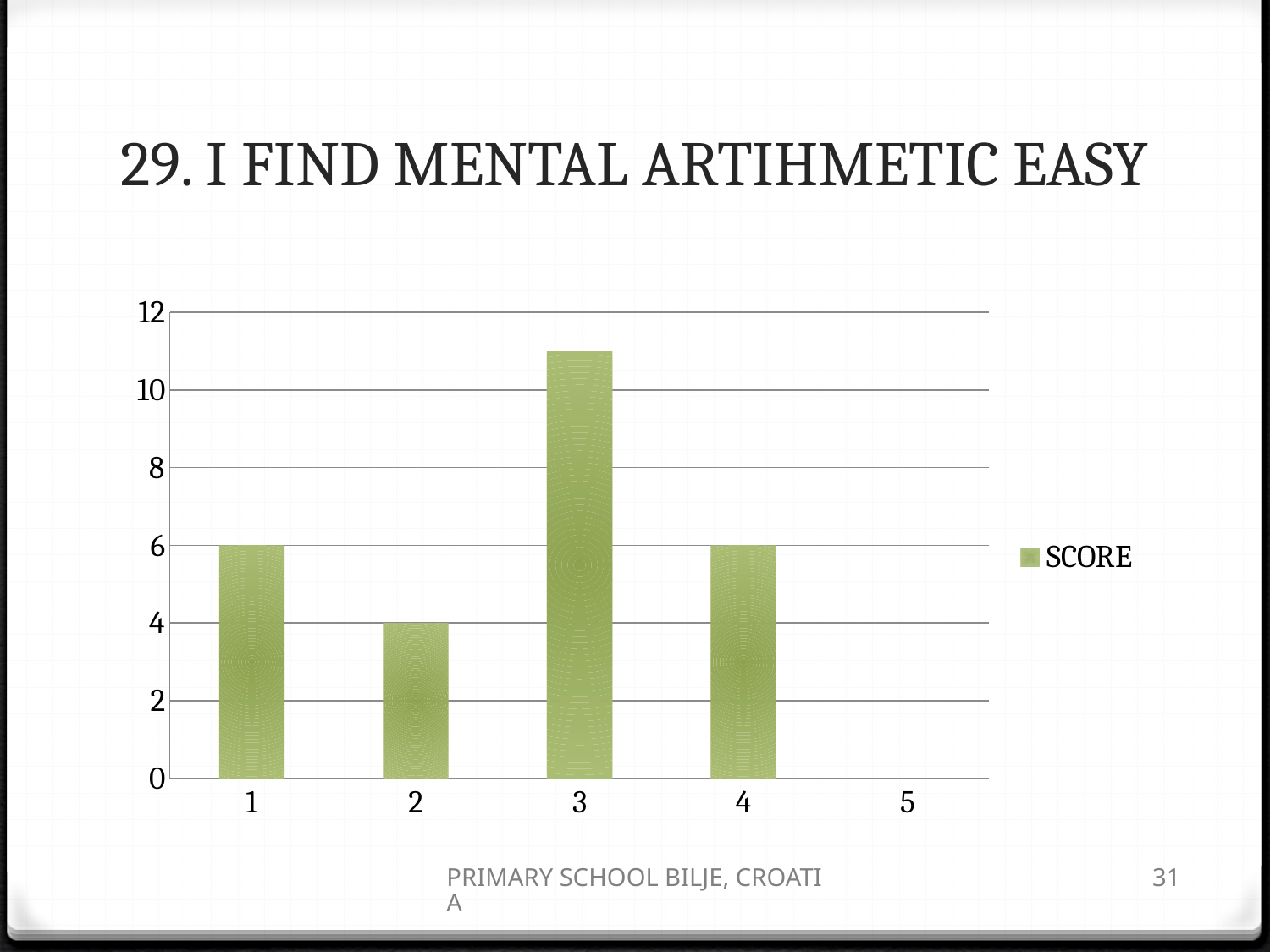
Which has a larger value, category 2 or category 4? 4 Which category has the lowest value? 5 Which category has the highest value? 3 What kind of chart is shown on the slide? bar chart What is the value for category 1? 6 What is the difference between the values for category 1 and category 2? 2 How many categories are shown on the x axis? 5 Is the value for category 3 greater or less than 10? greater What is the value for category 5? 0 What is the value for category 4? 6 How many series does the legend list? 1 What is the value for category 2? 4